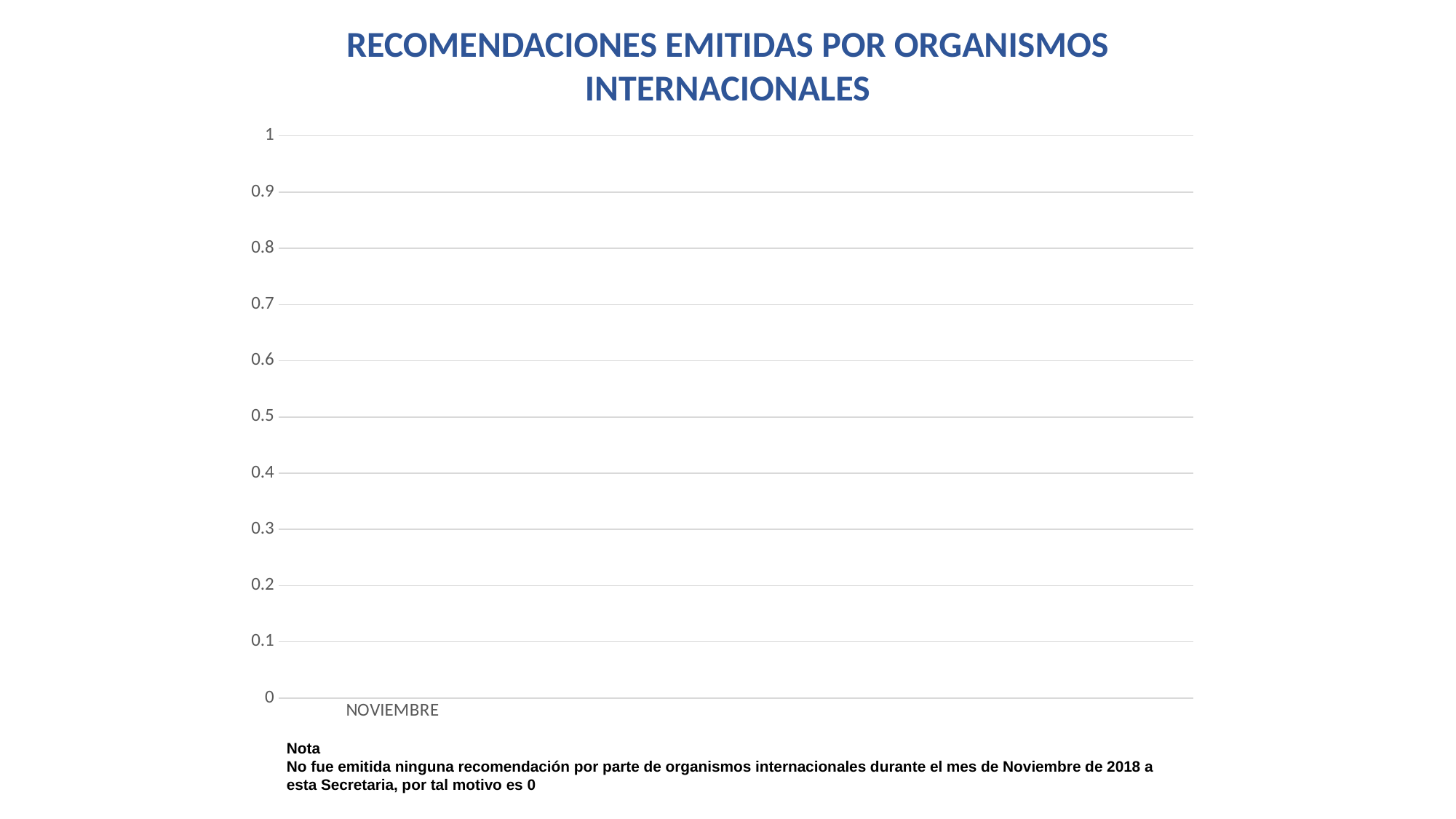
Is the value for NOVIEMBRE greater or less than 0.5? less Is the value for NOVIEMBRE greater or less than 0.1? less According to the slide, what is the value for NOVIEMBRE? 0 How many categories are shown on the x axis of the chart? 1 What is the only category label on the x axis of the chart? NOVIEMBRE What is the highest value shown on the y axis of the chart? 1 What is the title of the chart? RECOMENDACIONES EMITIDAS POR ORGANISMOS INTERNACIONALES